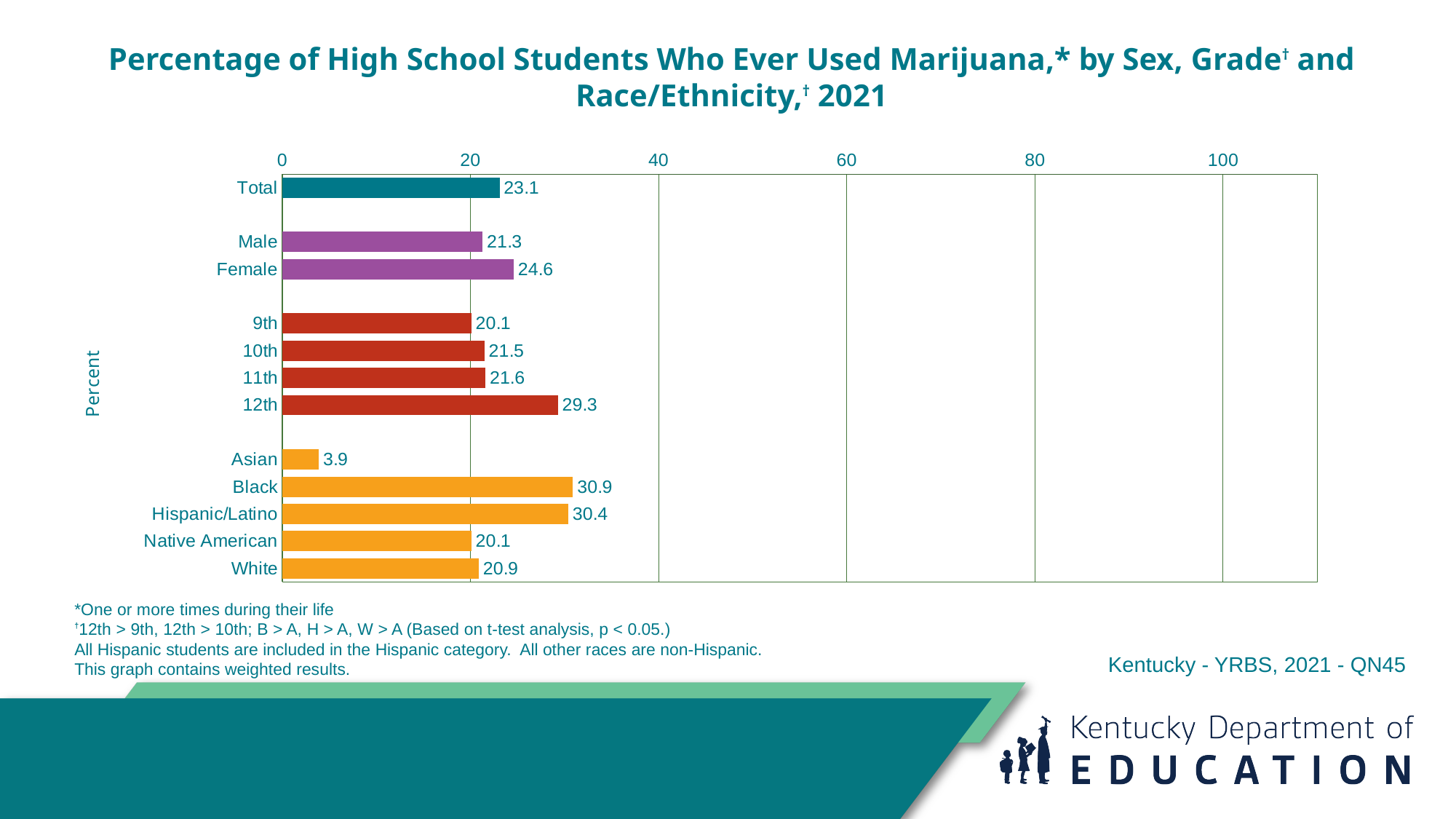
What is the difference between the Black and White values? 10.0 What is the value for Female? 24.6 Is the value for Hispanic/Latino greater or less than 20? greater Which category has the highest value? Black Which is larger, the value for 12th grade or the value for 9th grade? 12th How many categories are plotted on the chart? 13 What kind of chart is shown on the slide? bar chart What is the value for Asian students? 3.9 What is the difference between the Female and Male values? 3.3 What is the value for Total? 23.1 Which category has the lowest value? Asian What is the value for 12th grade? 29.3